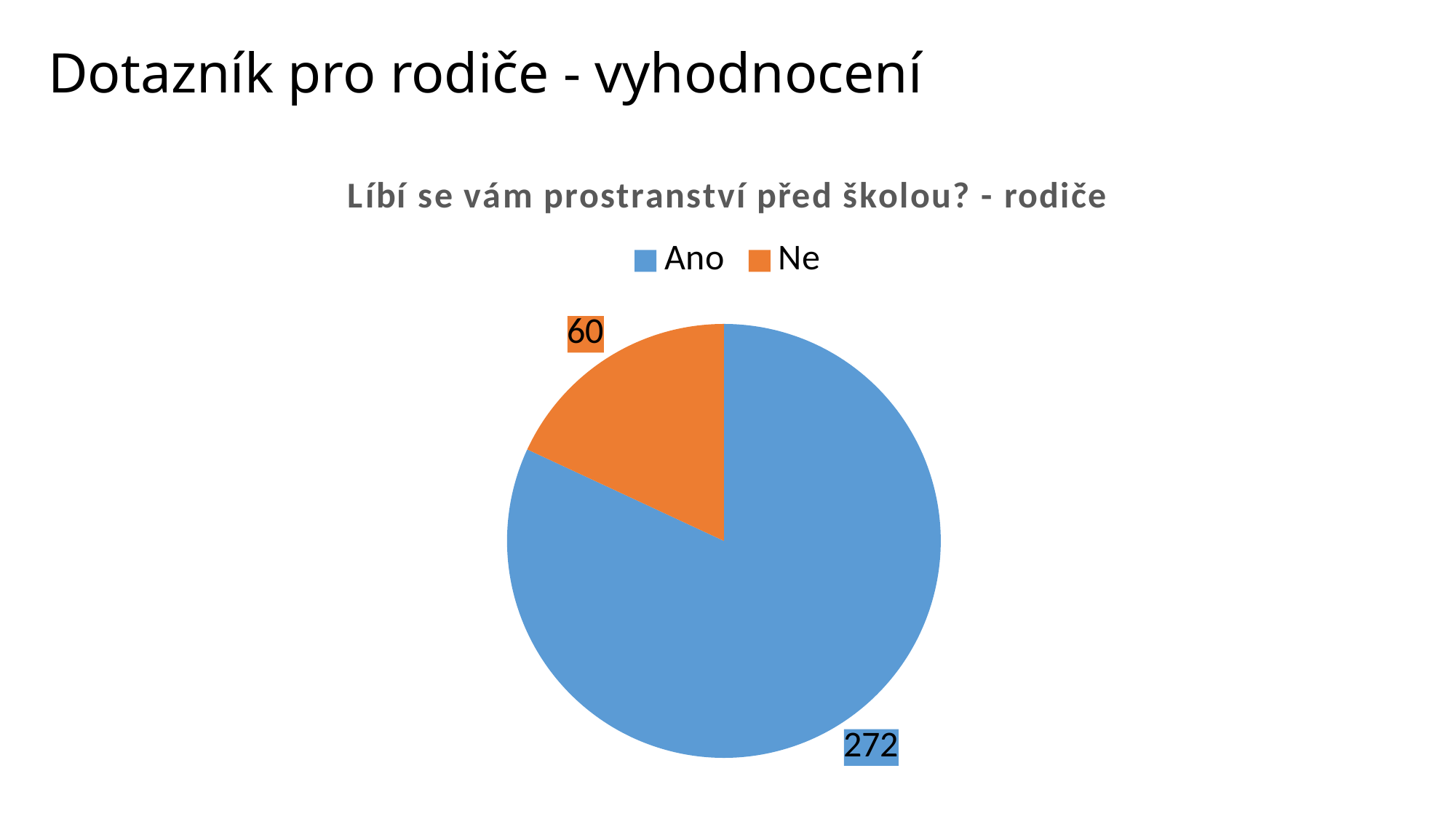
Which colour represents Ne in the pie chart? orange Which is larger, the value for Ano or the value for Ne? Ano How many entries does the legend list? 2 What is the value for Ano? 272 Which category has the largest slice? Ano What type of chart is shown on the slide? pie chart What is the value for Ne? 60 How many slices does the pie chart have? 2 What is the total of all slices in the pie chart? 332 Which category has the smallest slice? Ne What is the title of the chart? Líbí se vám prostranství před školou? - rodiče What is the difference between the values for Ano and Ne? 212